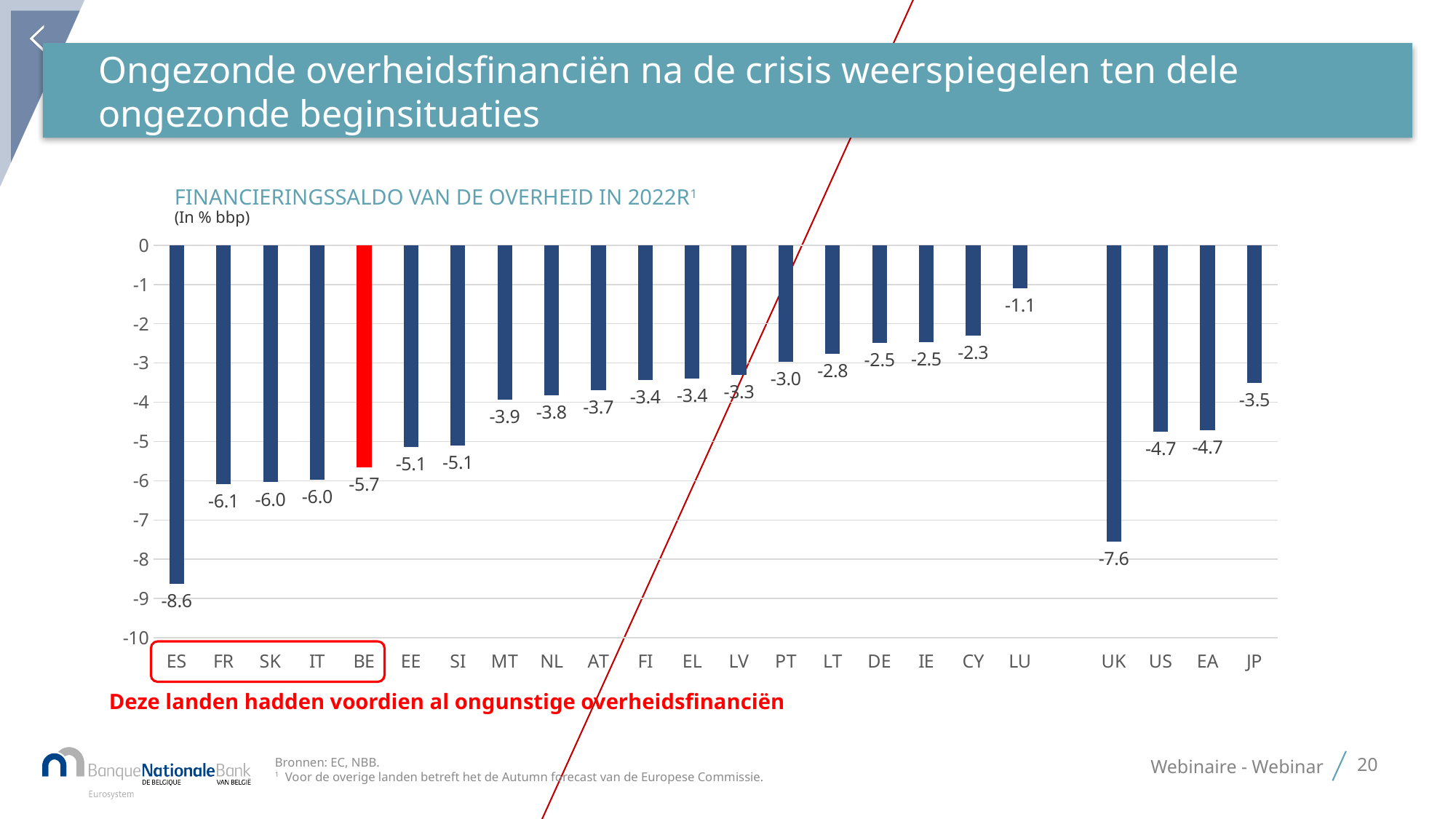
Which country has the highest (least negative) value? LU What unit is given under the chart title? In % bbp What is the difference between the values for ES and BE? 2.9 What is the value for UK? -7.6 What is the value for LU? -1.1 Which bar is coloured red instead of blue? BE What is the value for BE? -5.7 How many countries or regions are shown on the x axis? 23 What is the value for JP? -3.5 What kind of chart is this? Bar chart Which country has the lowest (most negative) value? ES Which has the larger (less negative) value, FR or NL? NL